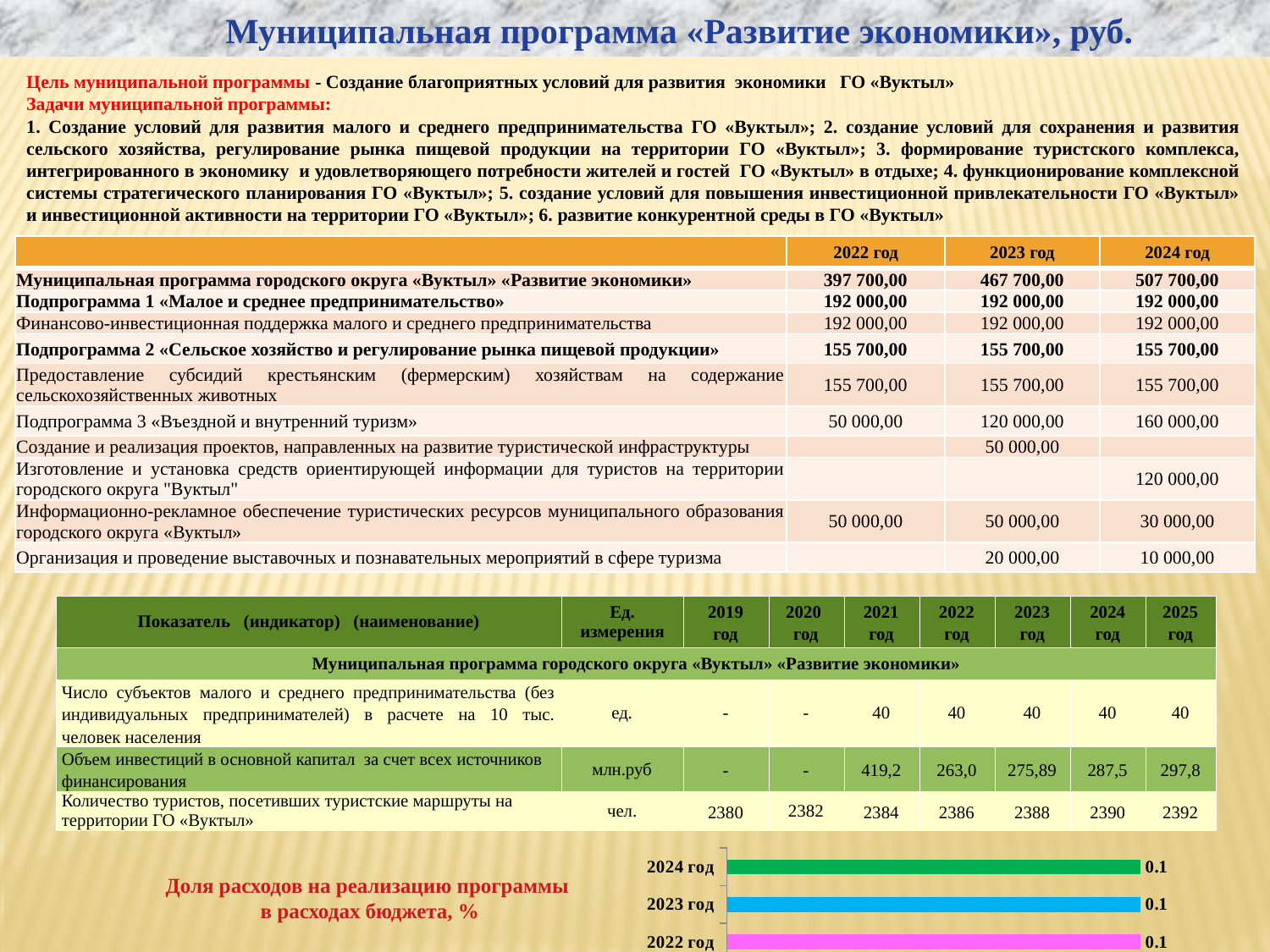
Do the values in the bar chart rise, fall, or stay the same from 2022 год to 2024 год? stay the same In the bar chart, what is the value for 2023 год? 0.1 In the bar chart, what is the value for 2024 год? 0.1 What is the title of the bar chart at the bottom of the slide? Доля расходов на реализацию программы в расходах бюджета, % What type of chart is shown at the bottom of the slide? bar chart In the bar chart, what is the value for 2022 год? 0.1 How many years (categories) are shown in the bar chart? 3 What is the difference between the values for 2024 год and 2022 год in the bar chart? 0 What colour is the bar for 2022 год in the bar chart? pink